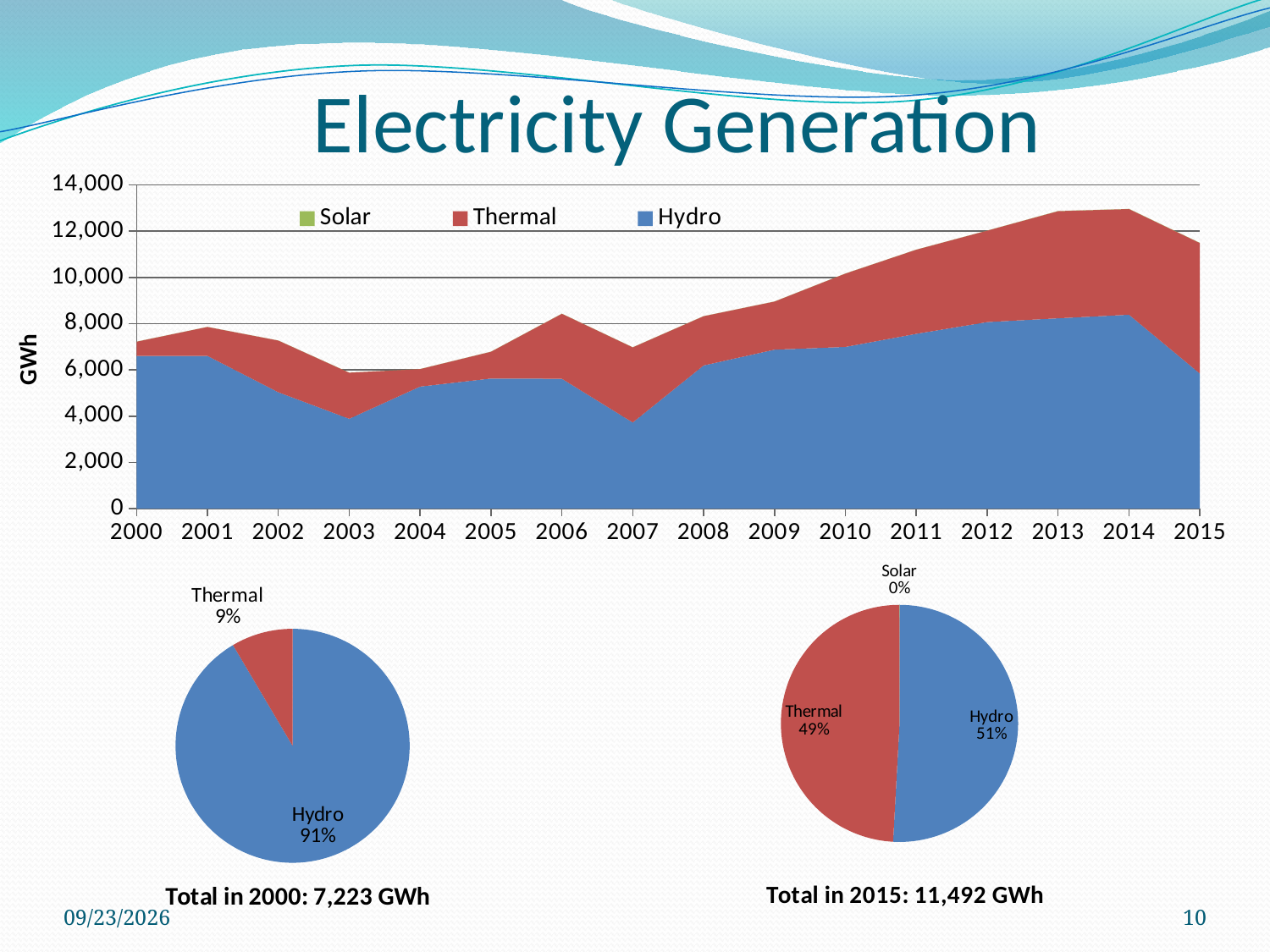
What total generation is stated for 2015 below the bottom-right pie chart? 11,492 GWh In the bottom-left pie chart (Total in 2000), what share does Hydro have? 91% In the top 'Electricity Generation' chart, is the total generation in 2014 greater or less than 12,000? greater In the bottom-right pie chart (Total in 2015), which is larger, Hydro or Thermal? Hydro In the top 'Electricity Generation' chart, what unit is shown on the y axis? GWh What kind of chart is the top chart titled 'Electricity Generation'? Area chart In the top 'Electricity Generation' chart, how many years are shown on the x axis? 16 In the top 'Electricity Generation' chart, is the Hydro value in 2007 greater or less than 4,000? less In the bottom-right pie chart (Total in 2015), what share does Thermal have? 49% In the bottom-left pie chart (Total in 2000), what share does Thermal have? 9% In the top 'Electricity Generation' chart, does total generation rise or fall from 2008 to 2014? rise In the top 'Electricity Generation' chart, how many series does the legend list? 3